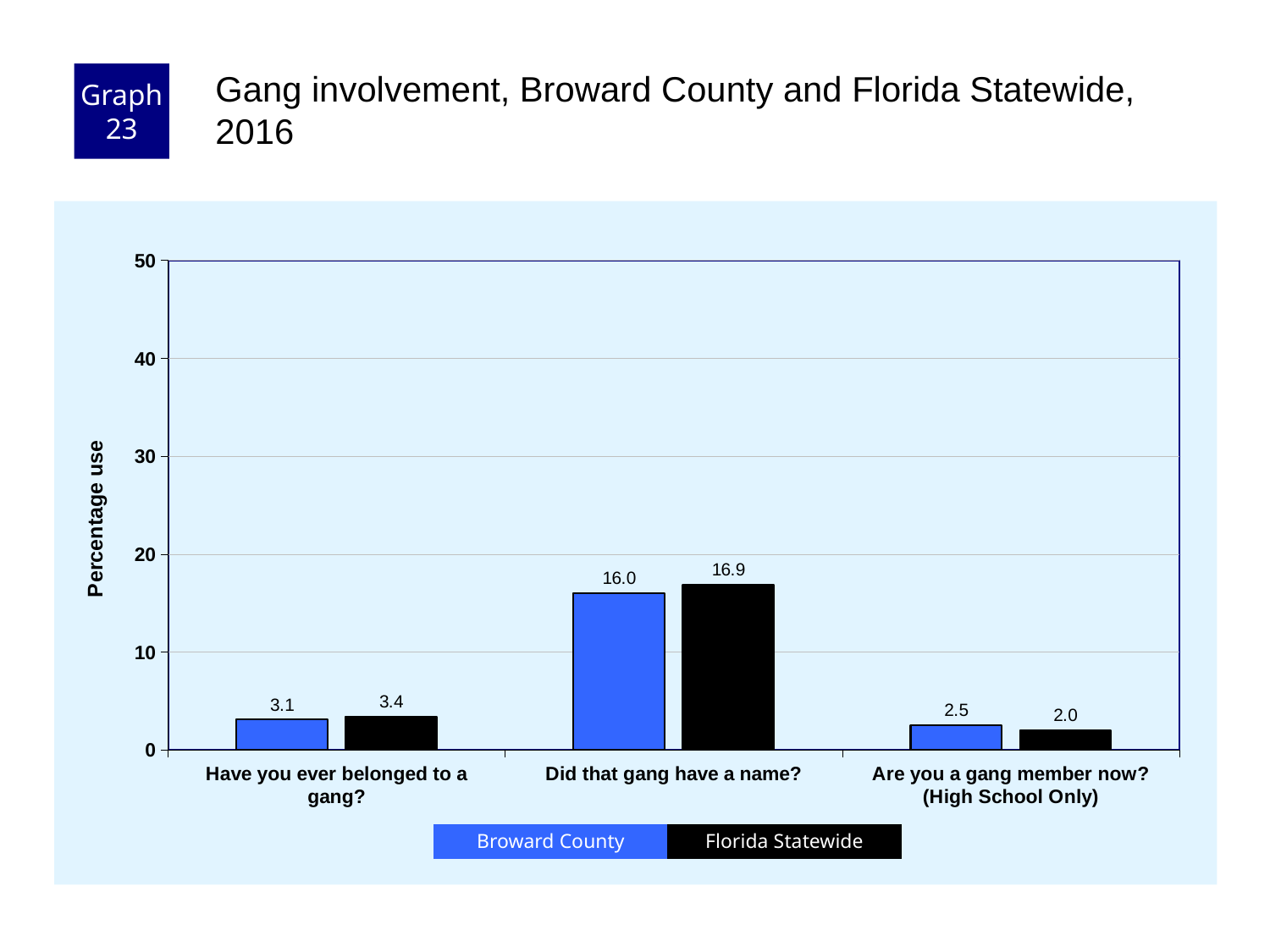
What kind of chart is shown? bar chart Which question has the highest Broward County value? Did that gang have a name? How many series does the legend list? 2 How many questions (categories) are shown on the x axis? 3 Which question has the lowest Florida Statewide value? Are you a gang member now? (High School Only) What is the difference between the Florida Statewide and Broward County values for "Did that gang have a name?"? 0.9 Is the Florida Statewide value for "Did that gang have a name?" greater or less than 20? less What is the label of the y axis? Percentage use What is the Broward County value for "Did that gang have a name?"? 16.0 What is the Florida Statewide value for "Are you a gang member now? (High School Only)"? 2.0 What is the Florida Statewide value for "Have you ever belonged to a gang?"? 3.4 For "Are you a gang member now? (High School Only)", which is larger: Broward County or Florida Statewide? Broward County